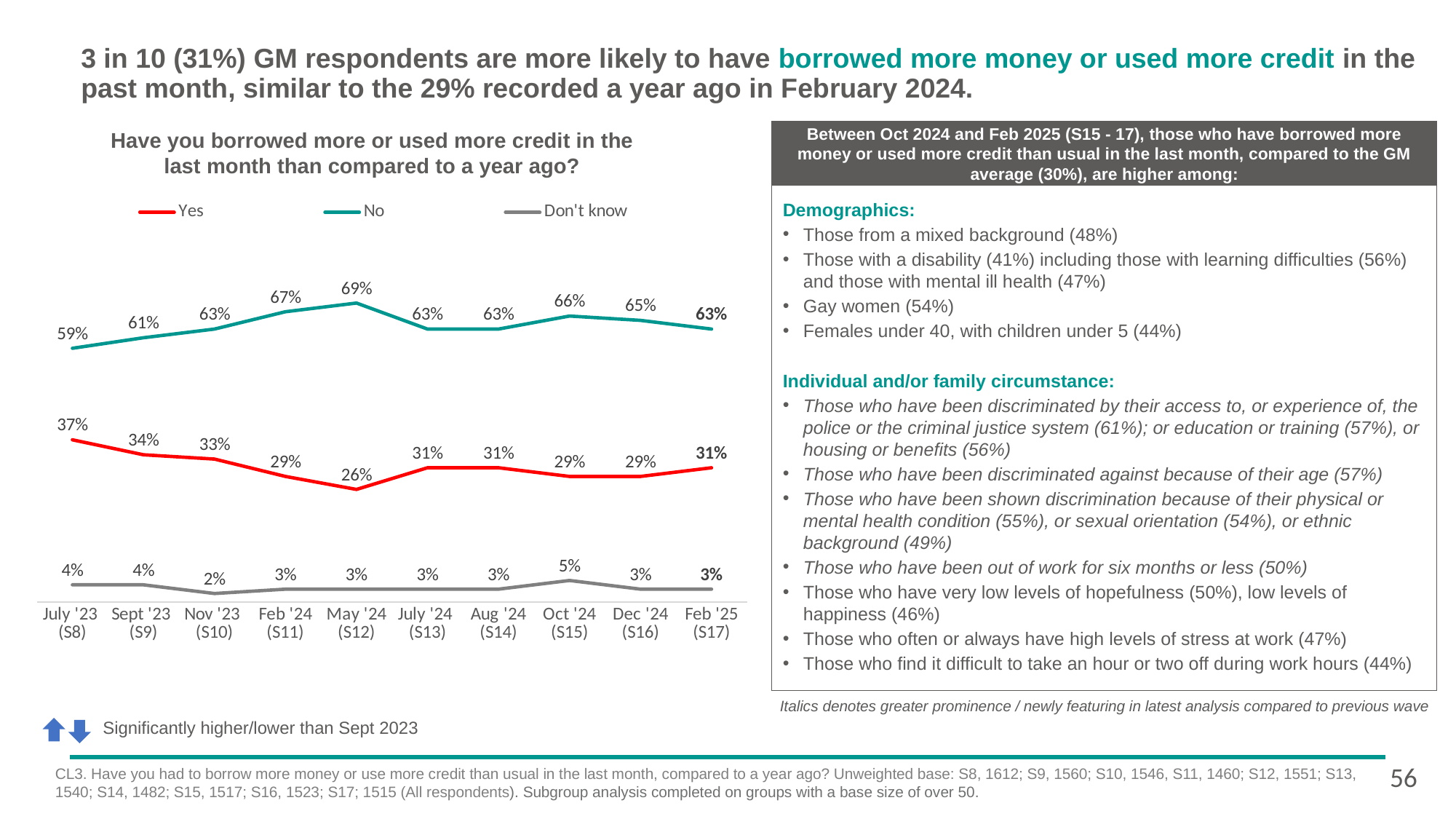
What is the value for 'Yes' in Feb '25 (S17)? 31% In which period is the 'No' series at its highest? May '24 (S12) In which period is the 'Yes' series at its highest? July '23 (S8) What is the value for 'No' in May '24 (S12)? 69% Which is larger in Feb '24 (S11): the 'Yes' value or the 'Don't know' value? Yes What is the value for 'Don't know' in Oct '24 (S15)? 5% How many series does the legend list? 3 Which series is shown in red in the legend? Yes In which period is the 'Yes' series at its lowest? May '24 (S12) What is the difference between the 'No' value and the 'Yes' value in July '23 (S8)? 22 percentage points What type of chart is shown on the slide? Line chart How many time points are plotted along the x axis? 10